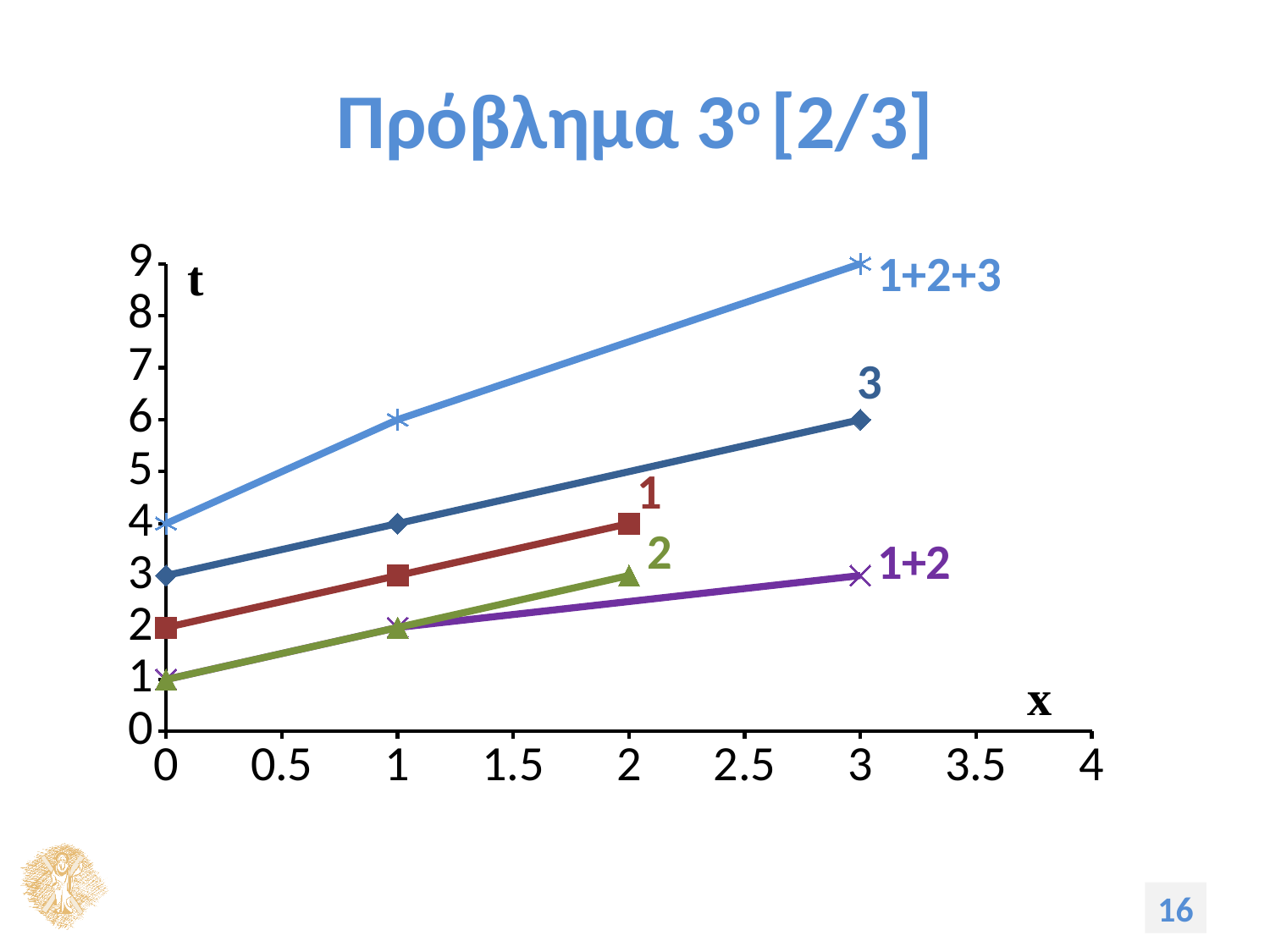
What type of chart is shown on the slide? line chart What is the value of t for series 1+2 at x = 3? 3 What is the value of t for series 1+2+3 at x = 3? 9 What is the value of t for series 1 at x = 2? 4 How many series are plotted on the chart? 5 What is the value of t for series 1+2+3 at x = 1? 6 What is the difference between the t values of series 1+2+3 and series 3 at x = 3? 3 Do the t values of series 2 rise or fall as x increases? rise What is the value of t for series 3 at x = 0? 3 Which series has the highest value of t at x = 3? 1+2+3 At x = 1, which series has a larger t value: series 3 or series 1? 3